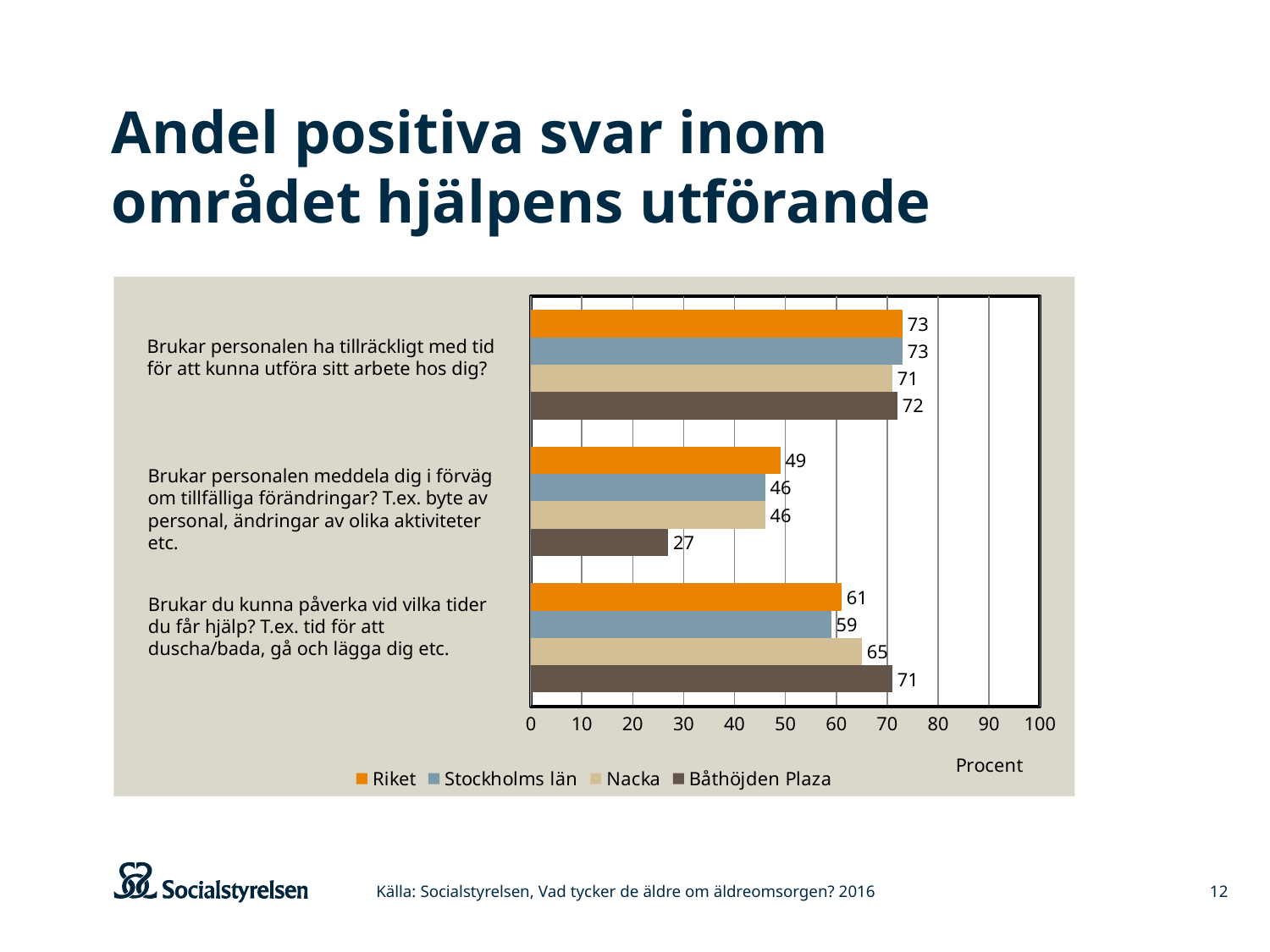
What is the value for Nacka on the question "Brukar du kunna påverka vid vilka tider du får hjälp?"? 65 What is the value for Stockholms län on the question "Brukar du kunna påverka vid vilka tider du får hjälp?"? 59 Which series has the highest value on the question "Brukar du kunna påverka vid vilka tider du får hjälp?"? Båthöjden Plaza How many question categories are shown on the chart? 3 What is the value for Båthöjden Plaza on the question "Brukar personalen meddela dig i förväg om tillfälliga förändringar?"? 27 What is the label on the horizontal axis of the chart? Procent How many series does the legend list? 4 Which series has the lowest value on the question "Brukar personalen meddela dig i förväg om tillfälliga förändringar?"? Båthöjden Plaza What is the difference between Riket and Båthöjden Plaza on the question "Brukar personalen meddela dig i förväg om tillfälliga förändringar?"? 22 Which is larger on the question "Brukar du kunna påverka vid vilka tider du får hjälp?": Riket or Nacka? Nacka What is the value for Riket on the question "Brukar personalen ha tillräckligt med tid för att kunna utföra sitt arbete hos dig?"? 73 What kind of chart is shown on the slide? Bar chart